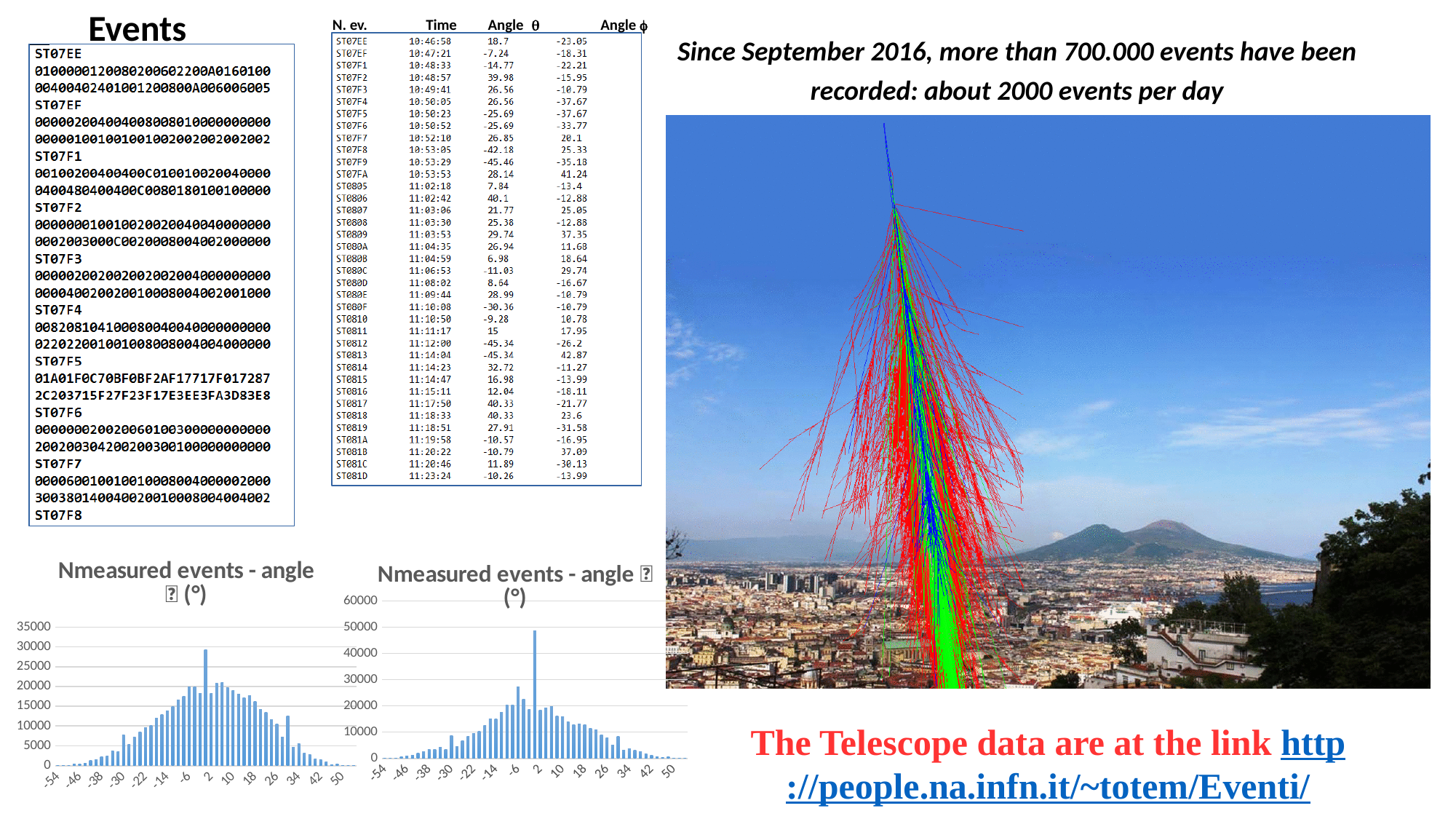
What is the highest value shown on the y-axis of the left bottom chart? 35000 In the right bottom chart, is the value of the bar at -6 greater or less than 20000? greater In the left bottom chart, which bar is taller: the one at 2 or the one at -30? 2 What is the highest value shown on the y-axis of the right bottom chart? 60000 In the right bottom chart, which bar is taller: the one at 2 or the one at 10? 2 What kind of chart is the left chart at the bottom of the slide, titled "Nmeasured events - angle"? bar chart In the left bottom chart, is the value of the bar at 50 greater or less than 5000? less What kind of chart is the right chart at the bottom of the slide, titled "Nmeasured events - angle"? bar chart